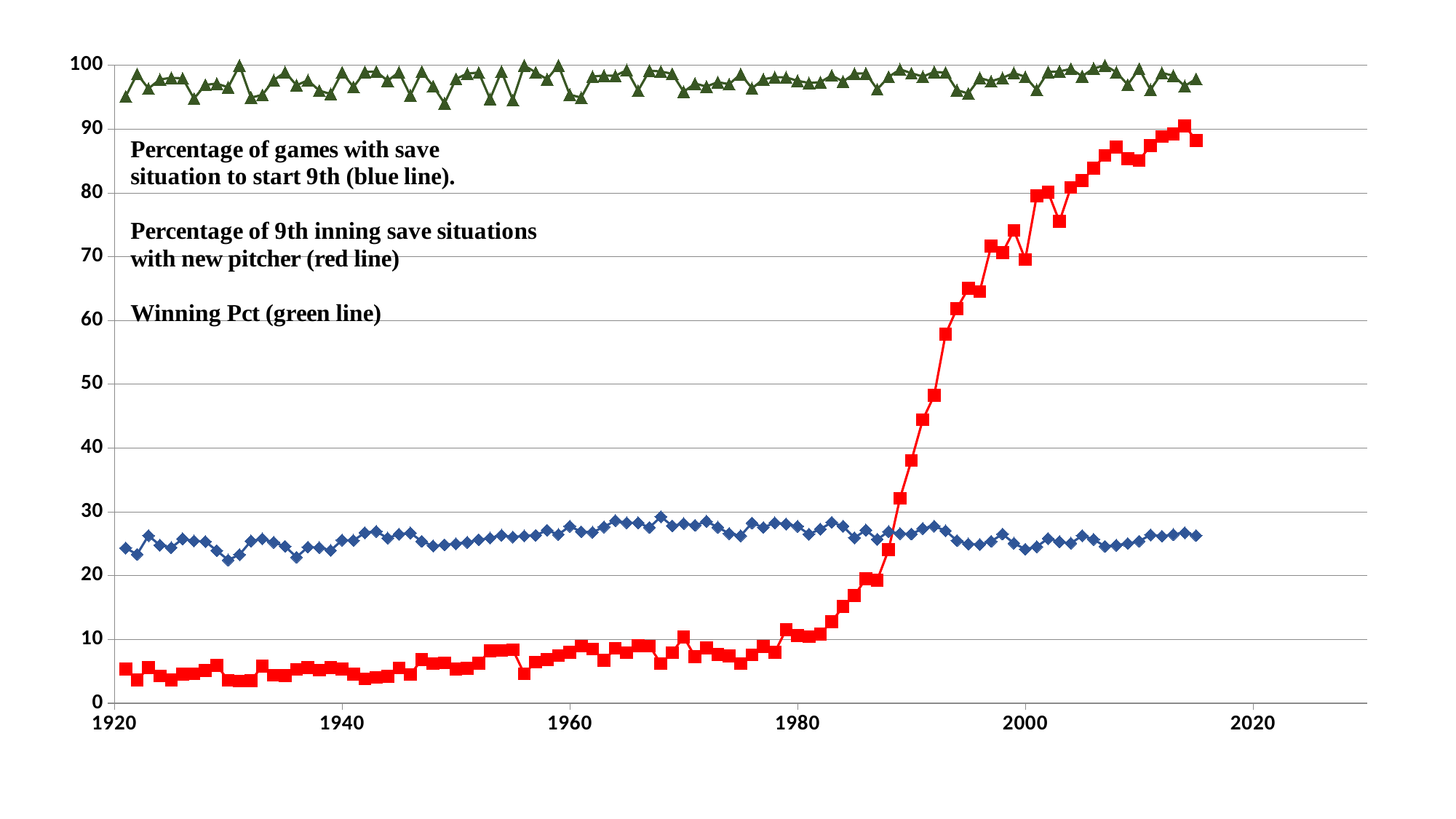
In 1950, which line has the higher value, the blue line or the red line? blue line How many data series are plotted on the chart? 3 Is the value of the red line in 1995 greater or less than 50? greater Does the red line rise or fall between 1980 and 2015? rise What kind of chart is shown on the slide? line chart Is the value of the red line in 2015 greater or less than 80? greater Is the value of the red line in 1960 greater or less than 20? less What does the blue line represent? Percentage of games with save situation to start 9th Which colour line represents Winning Pct? green In 2010, which line has the higher value, the red line or the blue line? red line